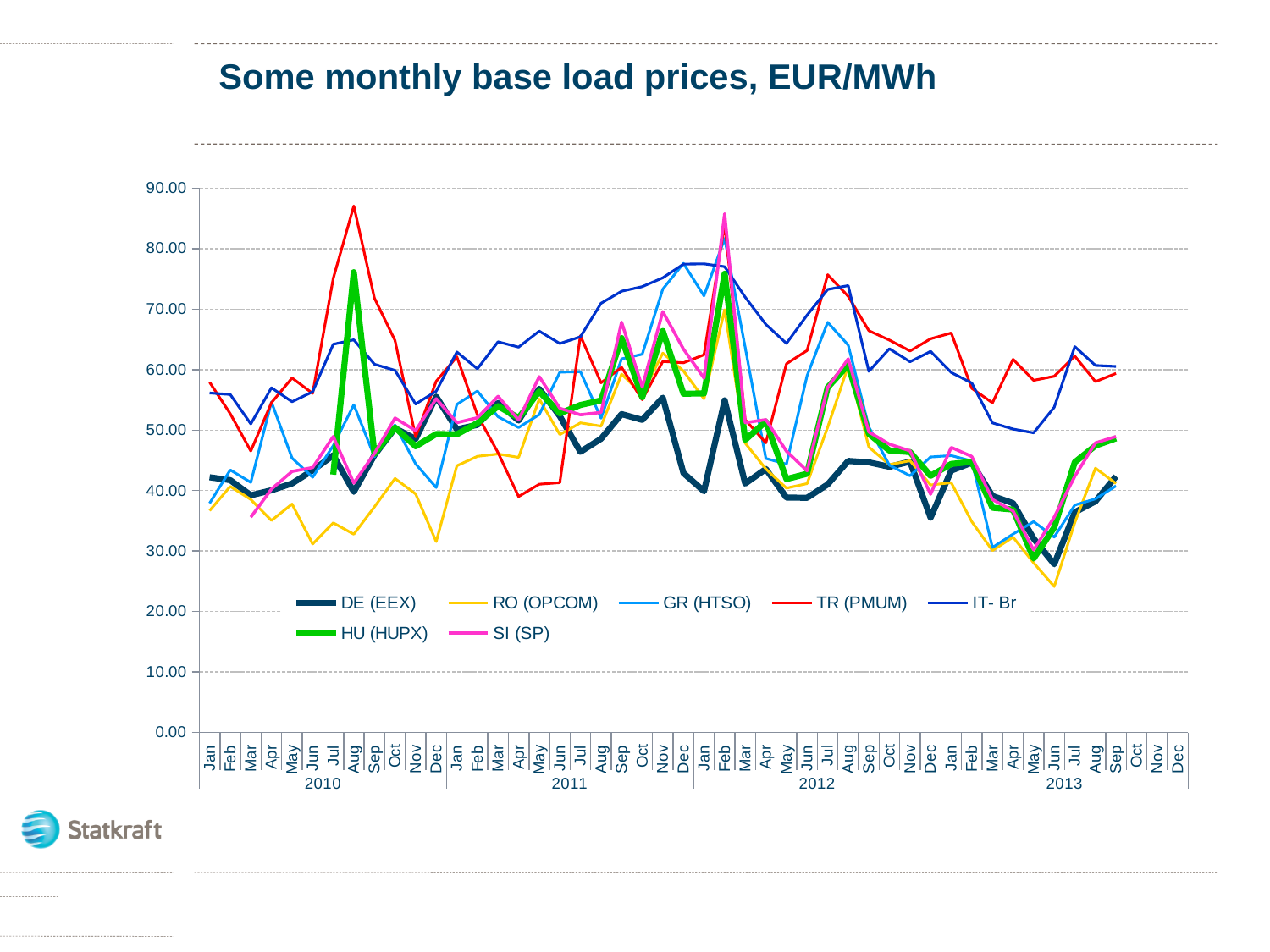
How many series does the legend list? 7 Is the value for TR (PMUM) in Aug 2010 greater or less than 80? greater Which series has the lowest value in Jun 2013? RO (OPCOM) Is the value for HU (HUPX) in Aug 2010 greater or less than 70? greater Does the DE (EEX) series rise or fall from Jan 2013 to Jun 2013? fall Which series has the highest value in Aug 2010? TR (PMUM) What kind of chart is shown on the slide? line chart What is the title of the chart? Some monthly base load prices, EUR/MWh In Dec 2011, which is larger, IT- Br or DE (EEX)? IT- Br Which series is drawn with the thick green line? HU (HUPX) Is the value for RO (OPCOM) in Jun 2013 greater or less than 30? less How many years are labelled on the x axis? 4